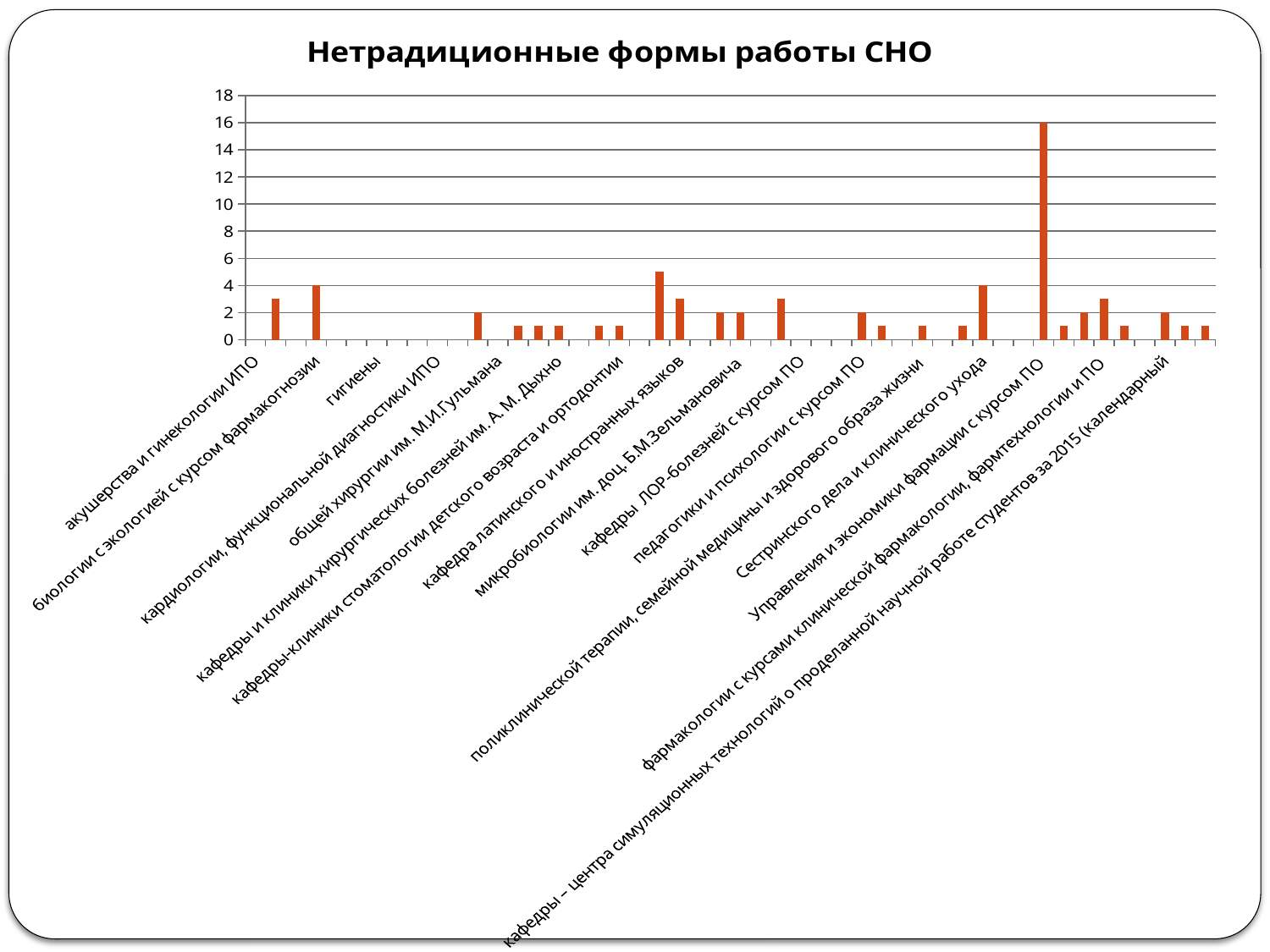
What is the title of the chart? Нетрадиционные формы работы СНО What kind of chart is shown on the slide? bar chart Which category has the tallest bar in the chart? Управления и экономики фармации с курсом ПО Is the value of the tallest bar greater or less than 14? greater What is the maximum value shown on the vertical axis? 18 Is the tallest bar greater or less than 10? greater What is the highest value reached by any bar in the chart? 16